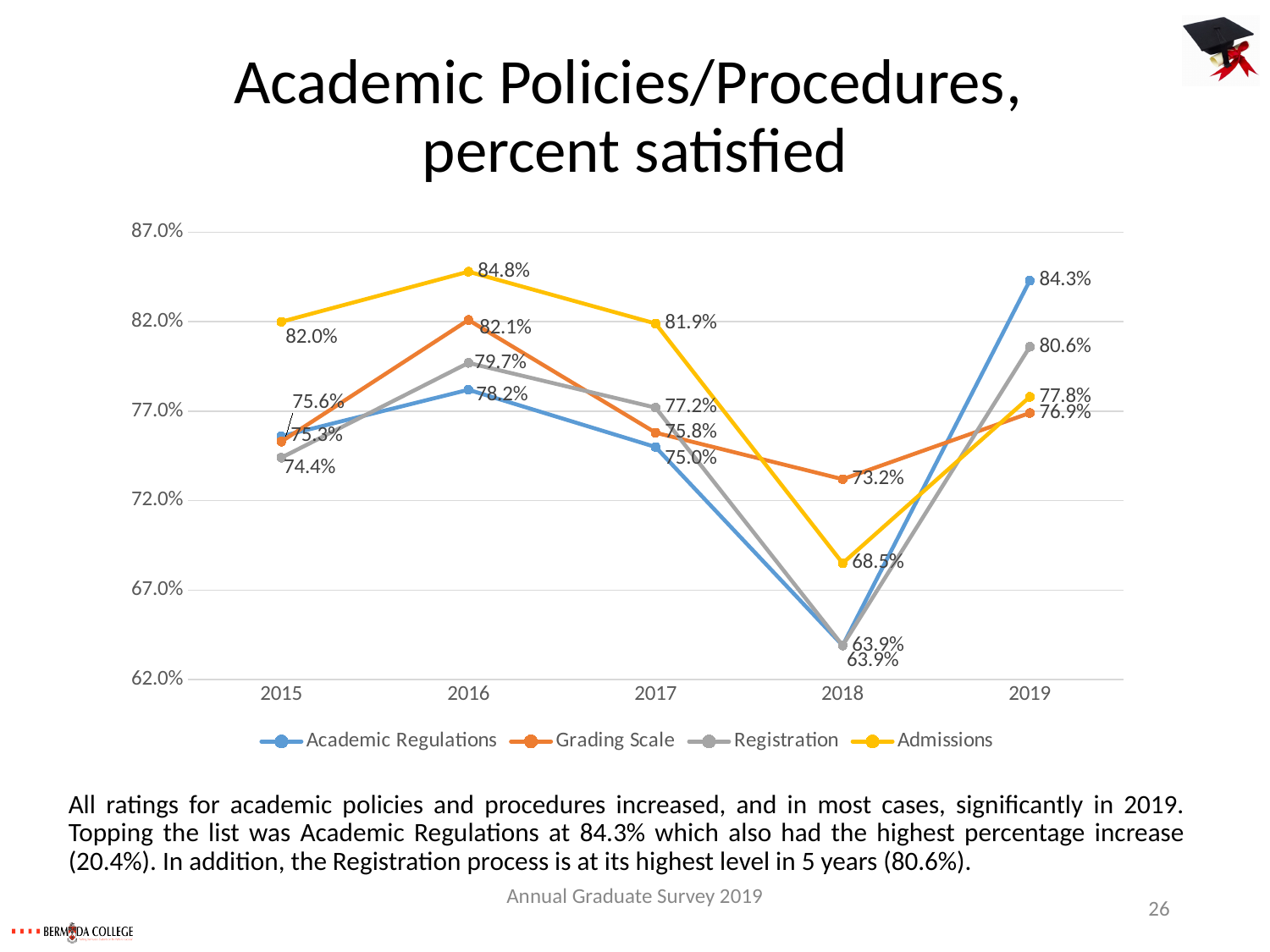
What kind of chart is shown on the slide? line chart What was the percent satisfied for Academic Regulations in 2019? 84.3% Did the Admissions series rise or fall from 2016 to 2018? fall What was the percent satisfied for Grading Scale in 2018? 73.2% In which year was the Admissions percent satisfied lowest? 2018 How many years are plotted along the x axis? 5 How many series does the legend list? 4 Which series had the highest percent satisfied in 2016? Admissions By how many percentage points did Academic Regulations increase from 2018 to 2019? 20.4% What was the percent satisfied for Admissions in 2016? 84.8% Is the value for Registration in 2019 greater or less than 82.0%? less In 2017, which was higher: Admissions or Registration? Admissions